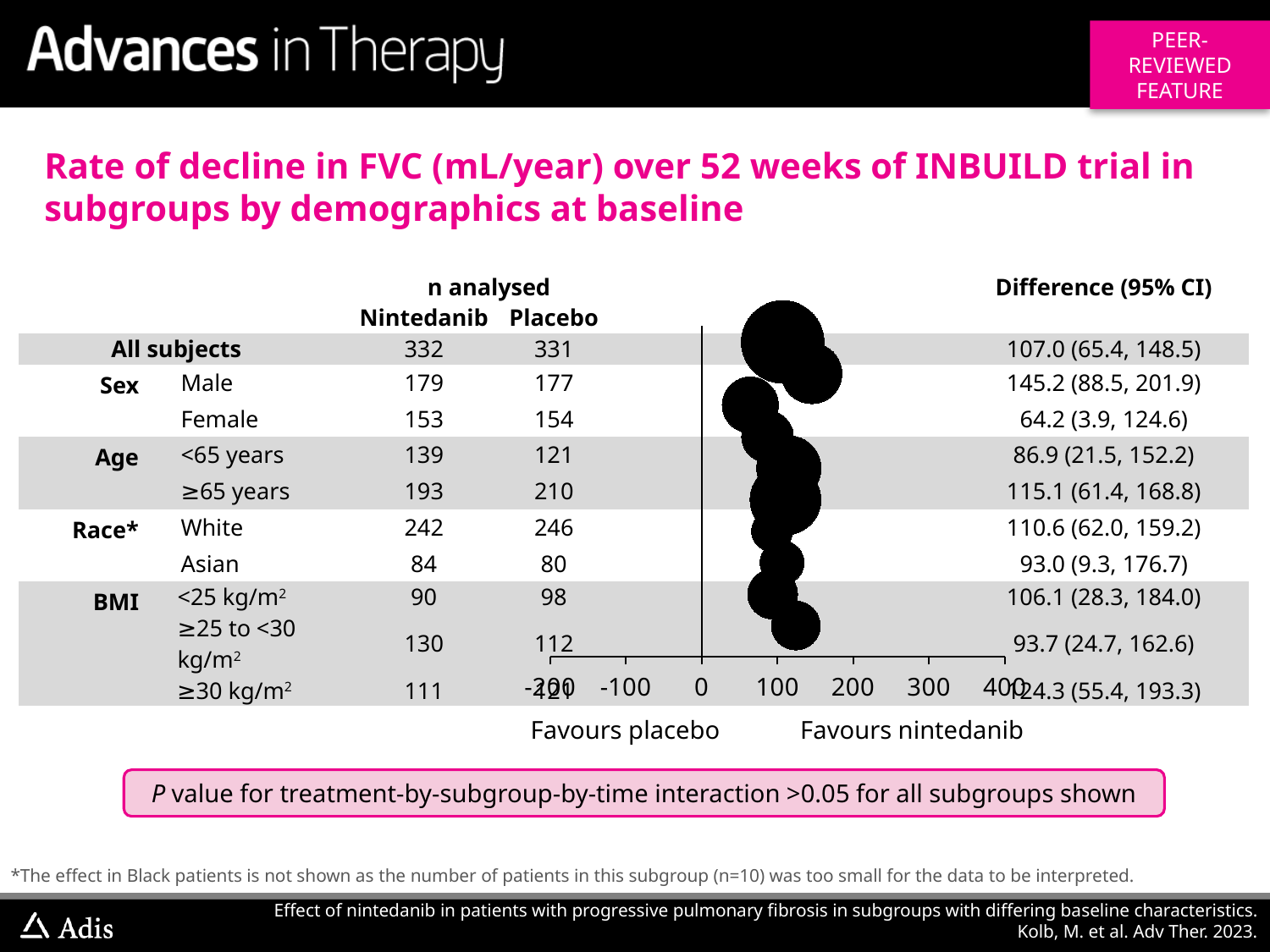
Is the point estimate for all subjects greater or less than 100 on the x axis? greater What label appears under the right-hand side of the x axis? Favours nintedanib Which subgroup has the largest point estimate for the difference in rate of FVC decline? Male What is the difference (95% CI) for the BMI ≥30 kg/m² subgroup? 124.3 (55.4, 193.3) How many subgroup rows, including All subjects, are shown in the forest plot? 10 Which has the larger point estimate for the difference: the <65 years subgroup or the ≥65 years subgroup? ≥65 years What kind of chart is shown on the slide? Forest plot Which subgroup has the smallest point estimate for the difference in rate of FVC decline? Female What is the difference between the point estimates for the Male and Female subgroups? 81.0 What is the difference (95% CI) for the Female subgroup? 64.2 (3.9, 124.6) What is the difference (95% CI) for the Male subgroup? 145.2 (88.5, 201.9) What is the difference (95% CI) in rate of decline in FVC for all subjects? 107.0 (65.4, 148.5)